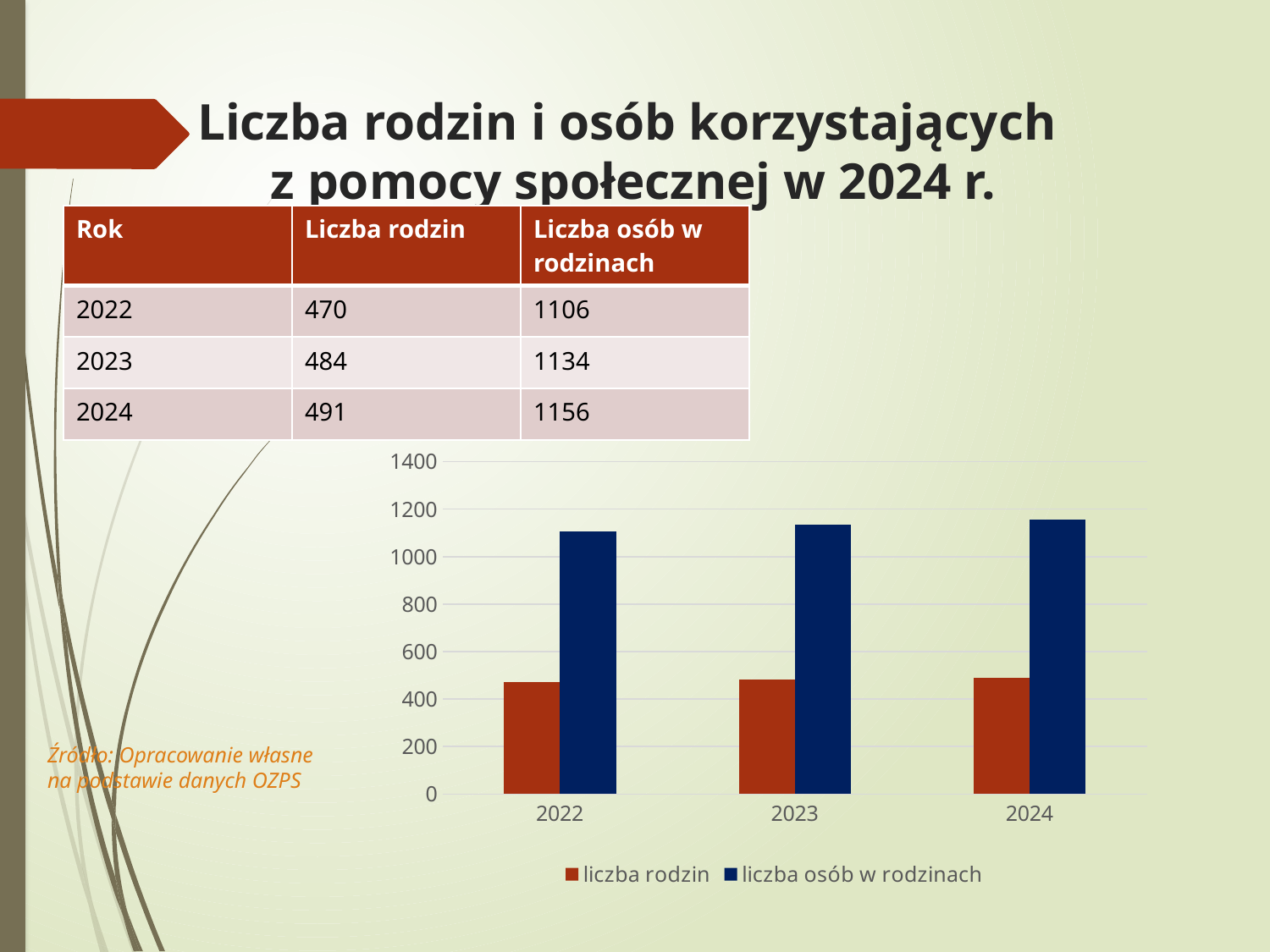
What is the value of 'liczba osób w rodzinach' for 2022? 1106 What is the difference between 'liczba osób w rodzinach' in 2024 and in 2022? 50 Which year has the highest value for 'liczba osób w rodzinach'? 2024 Do the values for 'liczba osób w rodzinach' rise or fall from 2022 to 2024? rise Which is larger in 2023: 'liczba rodzin' or 'liczba osób w rodzinach'? liczba osób w rodzinach What kind of chart is shown on the slide? bar chart Is the value for 'liczba osób w rodzinach' in 2023 greater or less than 1000? greater What is the value of 'liczba rodzin' for 2024? 491 How many series does the chart legend list? 2 How many years are shown on the x axis of the chart? 3 What colour are the bars for 'liczba rodzin' in the chart? red Which year has the lowest value for 'liczba rodzin'? 2022